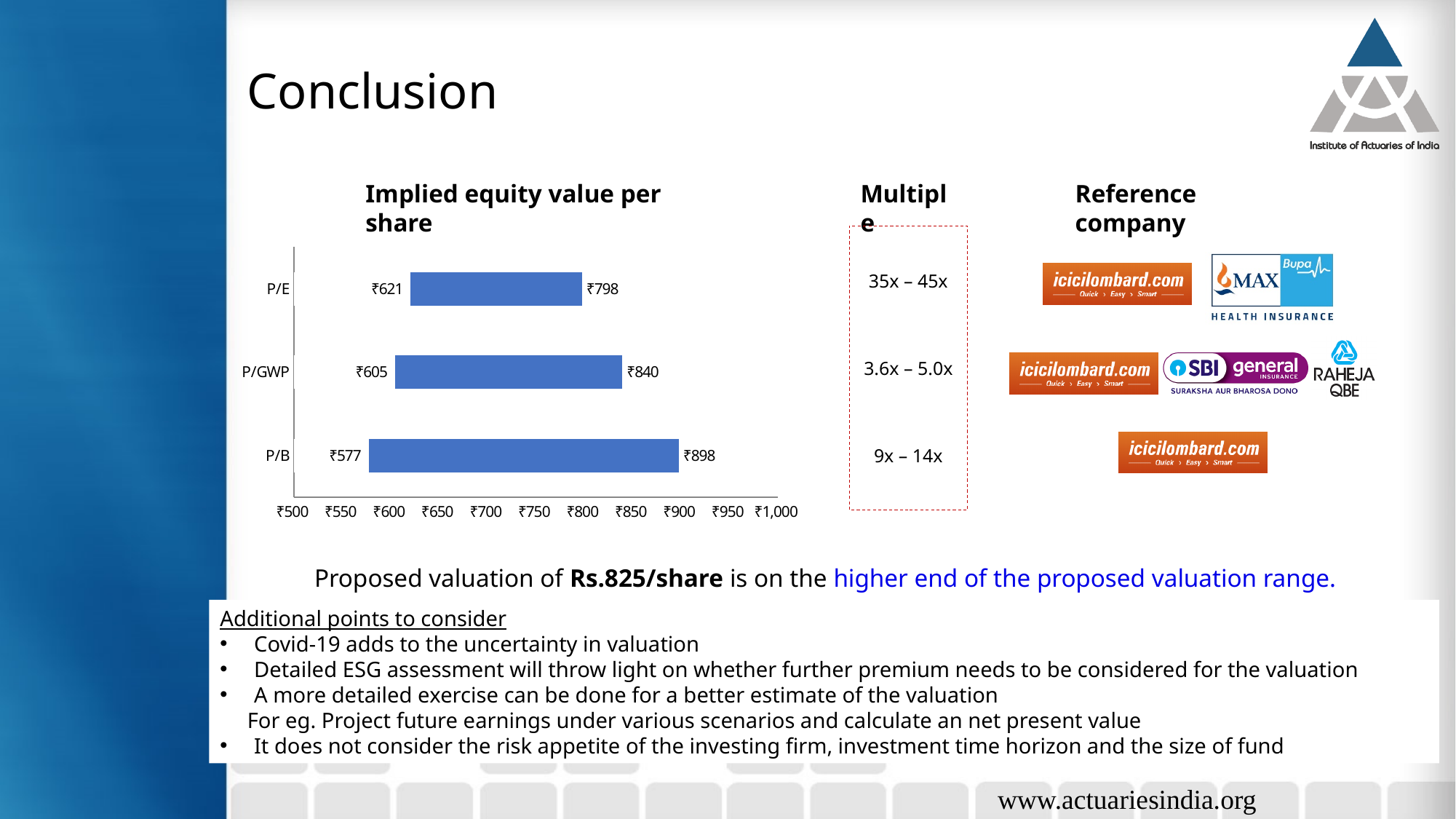
How many valuation methods are shown on the chart? 3 What is the title of the chart? Implied equity value per share Which is larger: the lower end of the P/E range or the lower end of the P/GWP range? P/E What is the upper end of the implied equity value per share for P/B? ₹898 What is the difference between the upper ends of the P/B and P/GWP ranges? ₹58 What type of chart is used to show the implied equity value per share? Bar chart Is the upper end of the P/GWP range greater or less than ₹800? greater Which valuation method has the lowest lower-end implied equity value per share? P/B What is the upper end of the implied equity value per share for P/GWP? ₹840 What is the width of the implied equity value range for P/E (upper end minus lower end)? ₹177 What is the lower end of the implied equity value per share for P/E? ₹621 Which valuation method has the highest upper-end implied equity value per share? P/B